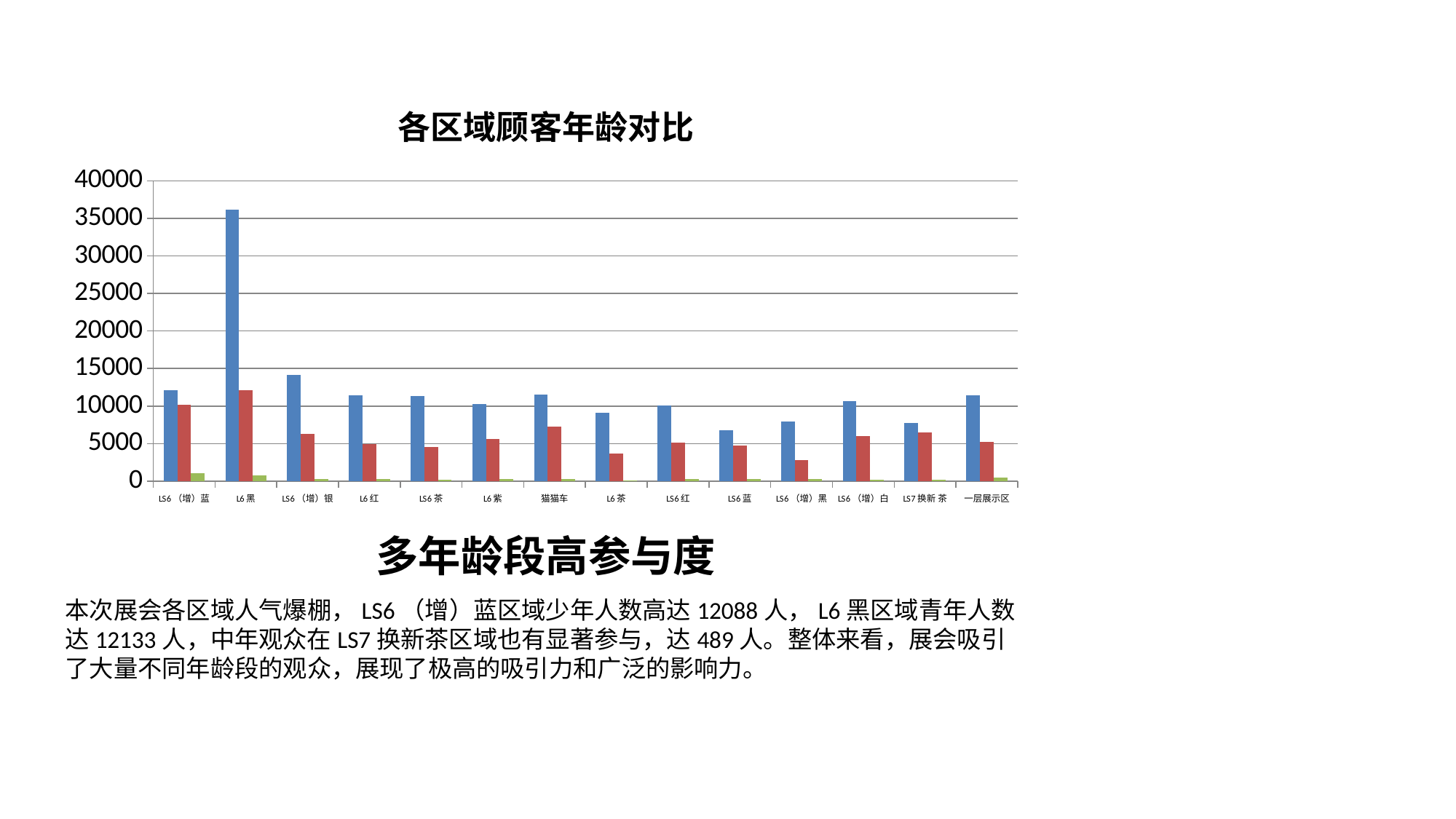
How many categories are shown on the x axis of the chart? 14 How many differently coloured bars (series) are plotted for each category? 3 Which category has the tallest blue bar? L6 黑 Is the red bar for LS6（增）黑 greater or less than 5000? less What kind of chart is shown on the slide? bar chart What is the highest value shown on the y axis? 40000 Is the blue bar for LS6 蓝 greater or less than 10000? less Which category has the shortest blue bar? LS6 蓝 Which has the larger red bar, 猫猫车 or L6 茶? 猫猫车 Is the blue bar for L6 黑 greater or less than 30000? greater Which category has the tallest red bar? L6 黑 What is the title of the chart? 各区域顾客年龄对比